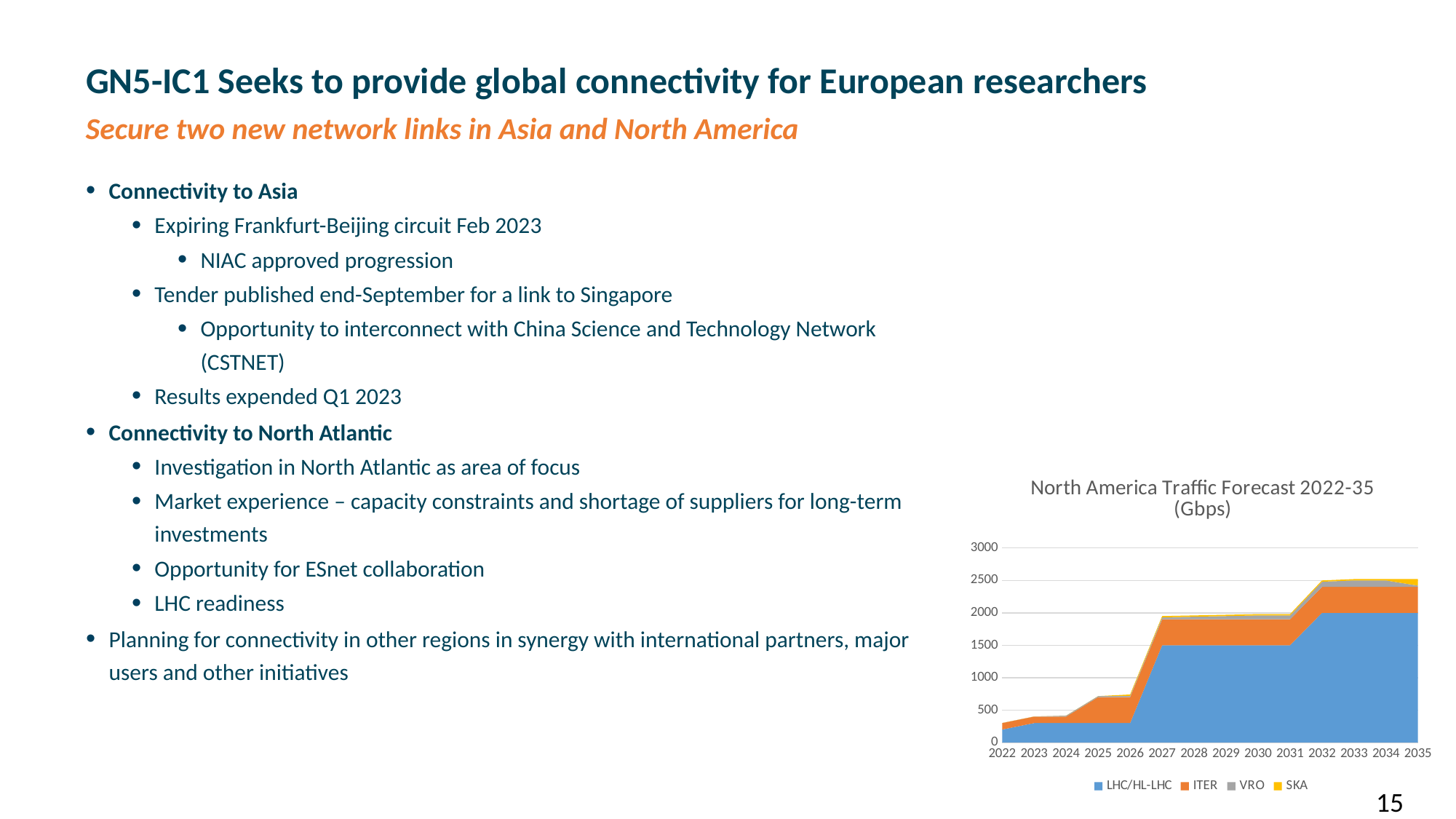
Is the total forecast traffic in 2022 greater or less than 500 Gbps? less How many years are shown along the x axis of the chart? 14 Does the total forecast traffic generally rise or fall from 2022 to 2035? Rise Which year has the larger total forecast traffic, 2026 or 2027? 2027 Is the total forecast traffic in 2027 greater or less than 1500 Gbps? greater What is the title of the chart on the slide? North America Traffic Forecast 2022-35 (Gbps) How many series does the chart's legend list? 4 Is the total forecast traffic in 2035 greater or less than 2000 Gbps? greater Which series is shown in blue in the chart? LHC/HL-LHC What kind of chart is shown on the slide? Stacked area chart Which year has the lowest total forecast traffic? 2022